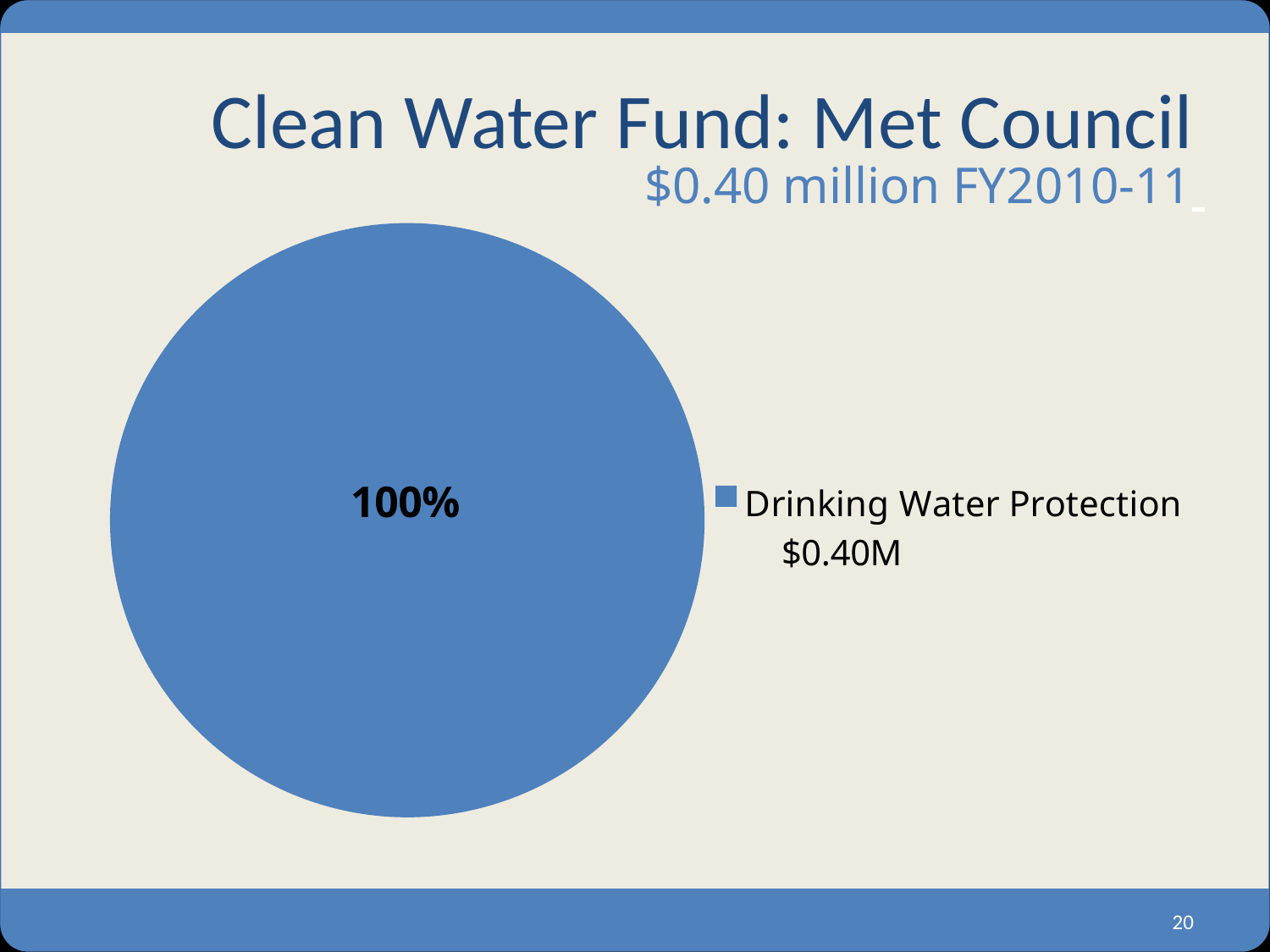
What dollar amount is shown in the legend for Drinking Water Protection? $0.40M What is the name of the only category in the pie chart? Drinking Water Protection What kind of chart is shown on the slide? pie chart What share of the pie does Drinking Water Protection represent? 100% How many slices does the pie chart have? 1 How many entries does the legend list? 1 What total amount and fiscal years are given in the slide subtitle? $0.40 million FY2010-11